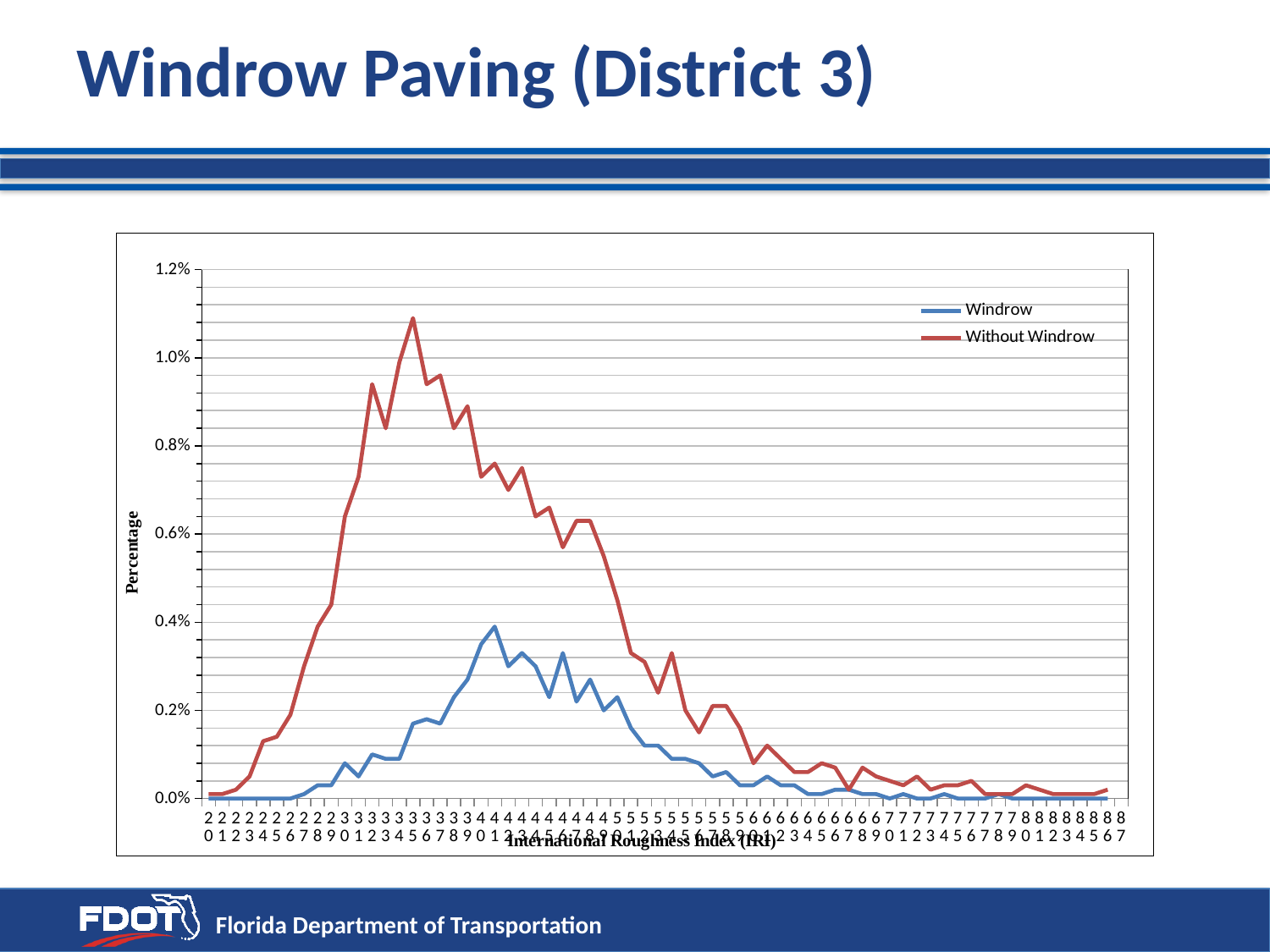
Which series reaches the higher peak value, Windrow or Without Windrow? Without Windrow What is the title of the vertical axis? Percentage What kind of chart is shown on the slide? Line chart Is the Without Windrow value at IRI 32 greater or less than 0.8%? greater Does the Without Windrow line generally rise or fall between IRI 35 and IRI 87? fall Does the Without Windrow line rise or fall between IRI 20 and IRI 35? rise Is the Windrow value at IRI 20 greater or less than 0.2%? less Is the Without Windrow value at IRI 80 greater or less than 0.2%? less What are the two series named in the legend? Windrow and Without Windrow How many series does the legend list? 2